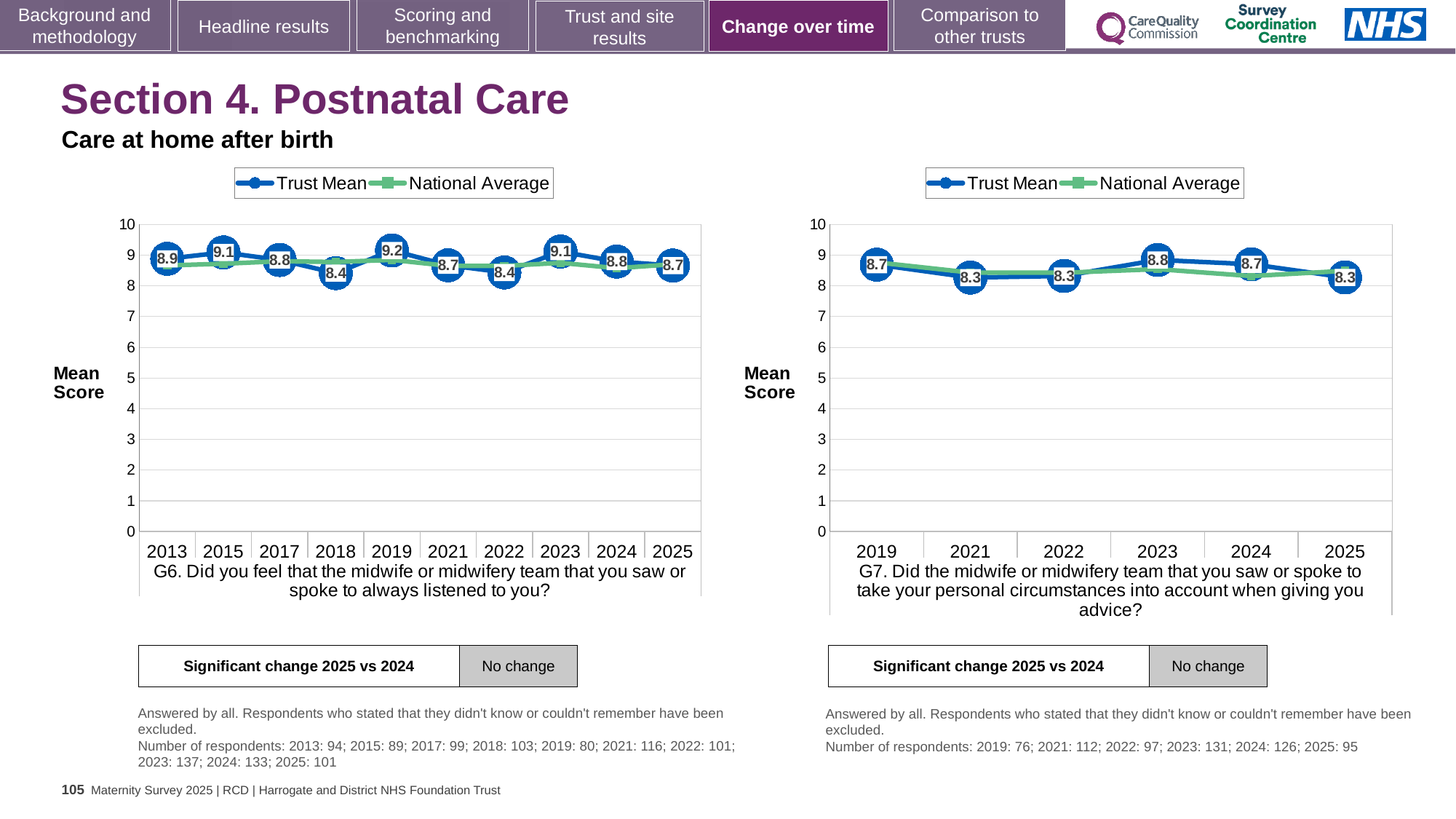
On the right chart (G7), what is the Trust Mean score for 2025? 8.3 On the left chart (G6), what is the Trust Mean score for 2019? 9.2 On the right chart (G7), how many series does the legend list? 2 On the right chart (G7), which is larger, the Trust Mean score for 2019 or for 2021? 2019 On the right chart (G7), which year has the highest Trust Mean score? 2023 What type of chart is the left chart (G6)? Line chart On the left chart (G6), is the Trust Mean score for 2023 greater or less than 9? greater On the left chart (G6), which year has the highest Trust Mean score? 2019 On the left chart (G6), how many years are plotted on the x axis? 10 On the left chart (G6), what is the difference between the Trust Mean scores for 2019 and 2018? 0.8 On the right chart (G7), what is the Trust Mean score for 2023? 8.8 On the left chart (G6), what is the Trust Mean score for 2025? 8.7